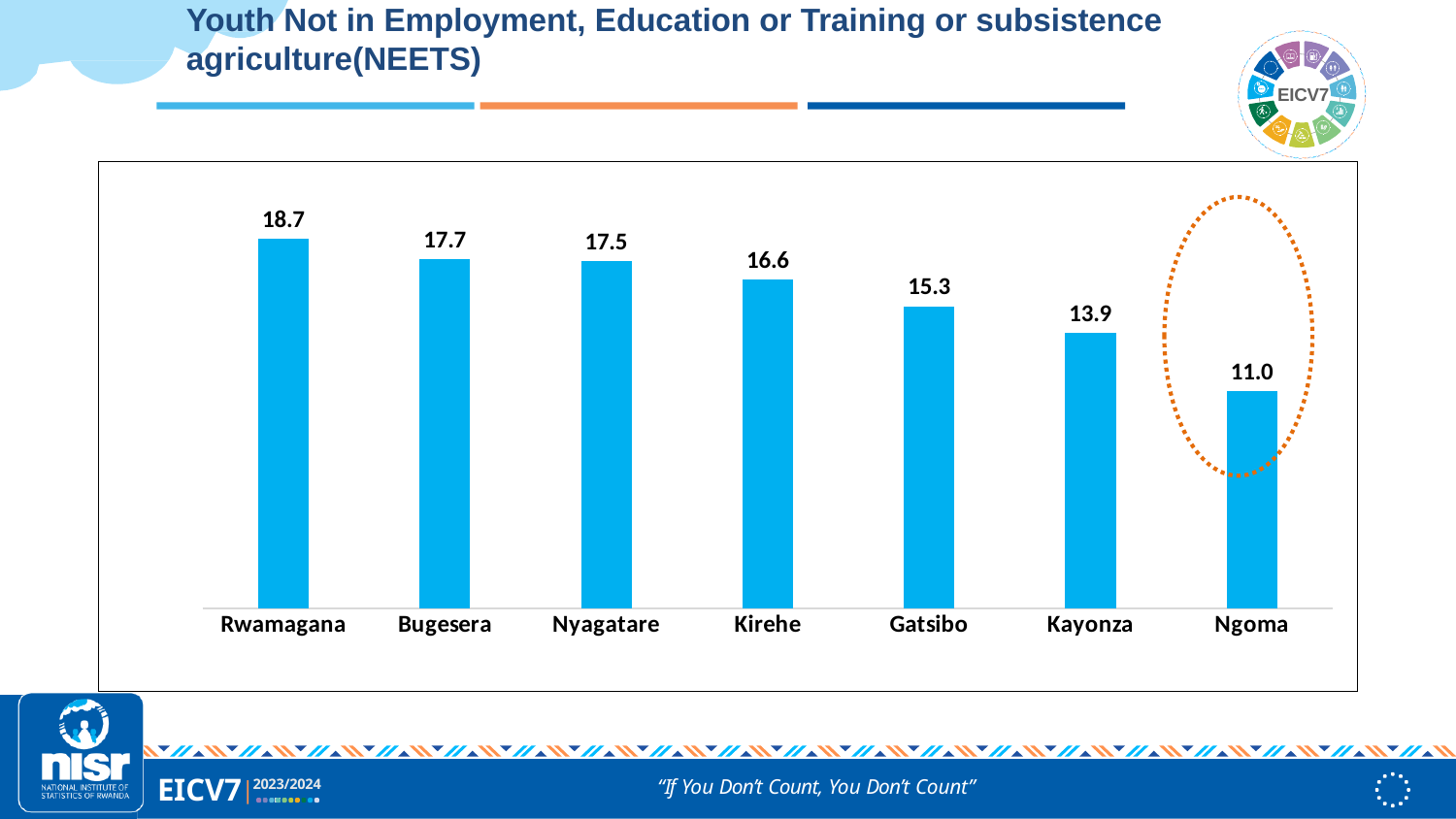
Which is larger, the value for Bugesera or the value for Kirehe? Bugesera What is the value for Kirehe? 16.6 What is the value for Rwamagana? 18.7 Do the values rise or fall from left to right across the districts? Fall Which district has the lowest value? Ngoma What is the value for Ngoma? 11.0 What is the difference between the values for Gatsibo and Kayonza? 1.4 What kind of chart is shown on the slide? Bar chart Which district's bar is highlighted with a dotted orange circle? Ngoma What is the difference between the values for Rwamagana and Ngoma? 7.7 Which district has the highest value? Rwamagana How many districts are shown in the chart? 7